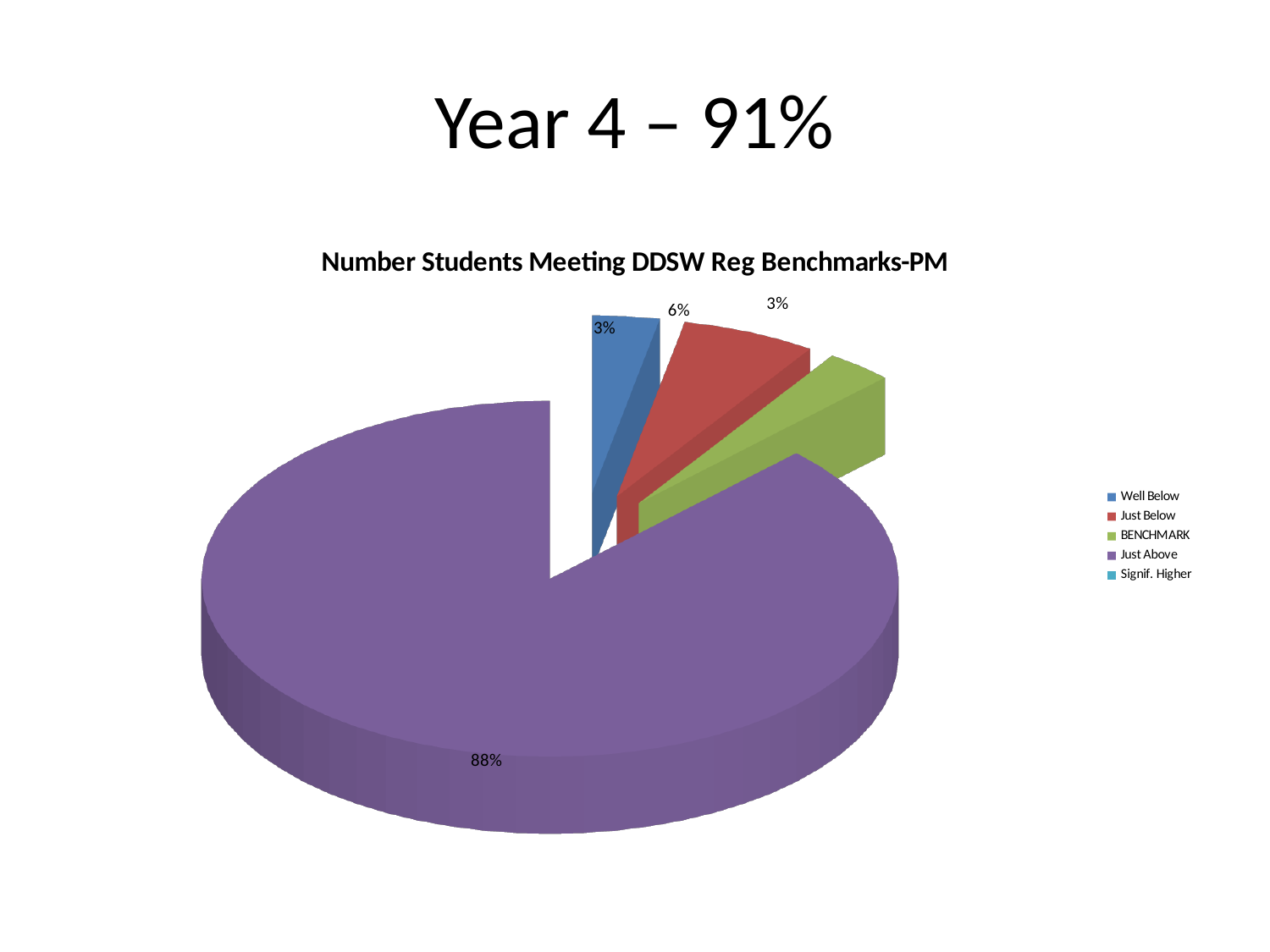
What is the title of the chart? Number Students Meeting DDSW Reg Benchmarks-PM How many categories are listed in the chart's legend? 5 What is the difference in percentage points between the Just Above slice and the Just Below slice? 82% What share of the pie does the Well Below slice represent? 3% Which is larger, the Just Below slice or the Well Below slice? Just Below Which category has the largest slice of the pie? Just Above How many slices are visible in the pie? 4 What share of the pie does the Just Below slice represent? 6% What colour is the Just Above slice? purple What share of the pie does the BENCHMARK slice represent? 3% What kind of chart is shown on the slide? pie chart